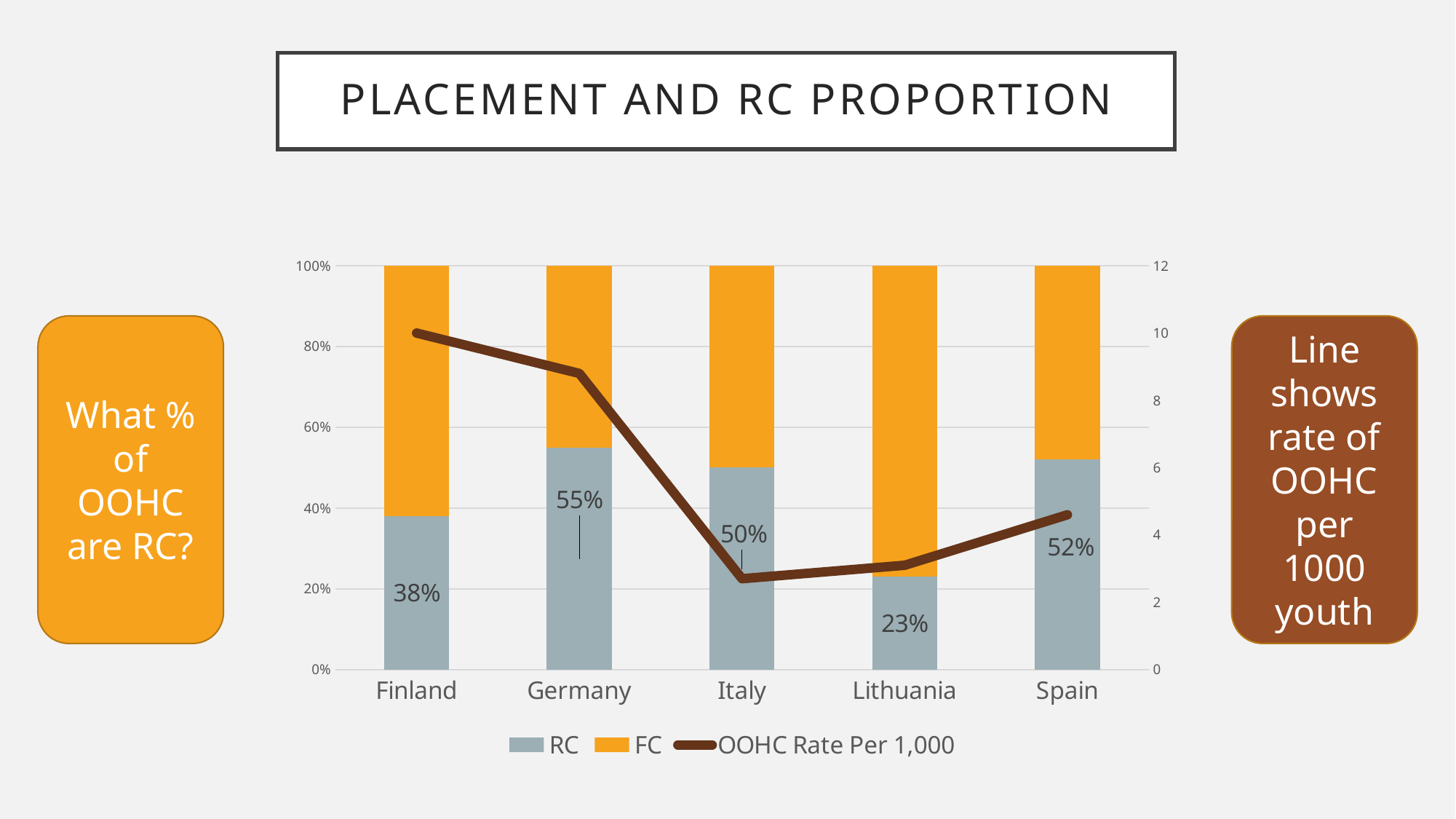
Is the OOHC Rate Per 1,000 for Finland greater or less than 8? greater Which country has the highest RC percentage? Germany How many countries are shown on the x axis? 5 How many series does the legend list? 3 What is the RC percentage for Lithuania? 23% Does the OOHC Rate Per 1,000 line rise or fall from Finland to Italy? fall Is the OOHC Rate Per 1,000 for Italy greater or less than 4? less Which has a larger RC percentage, Finland or Spain? Spain What is the RC percentage for Finland? 38% What is the RC percentage for Spain? 52% Which country has the lowest RC percentage? Lithuania What is the difference between the RC percentage for Germany and for Lithuania? 32 percentage points